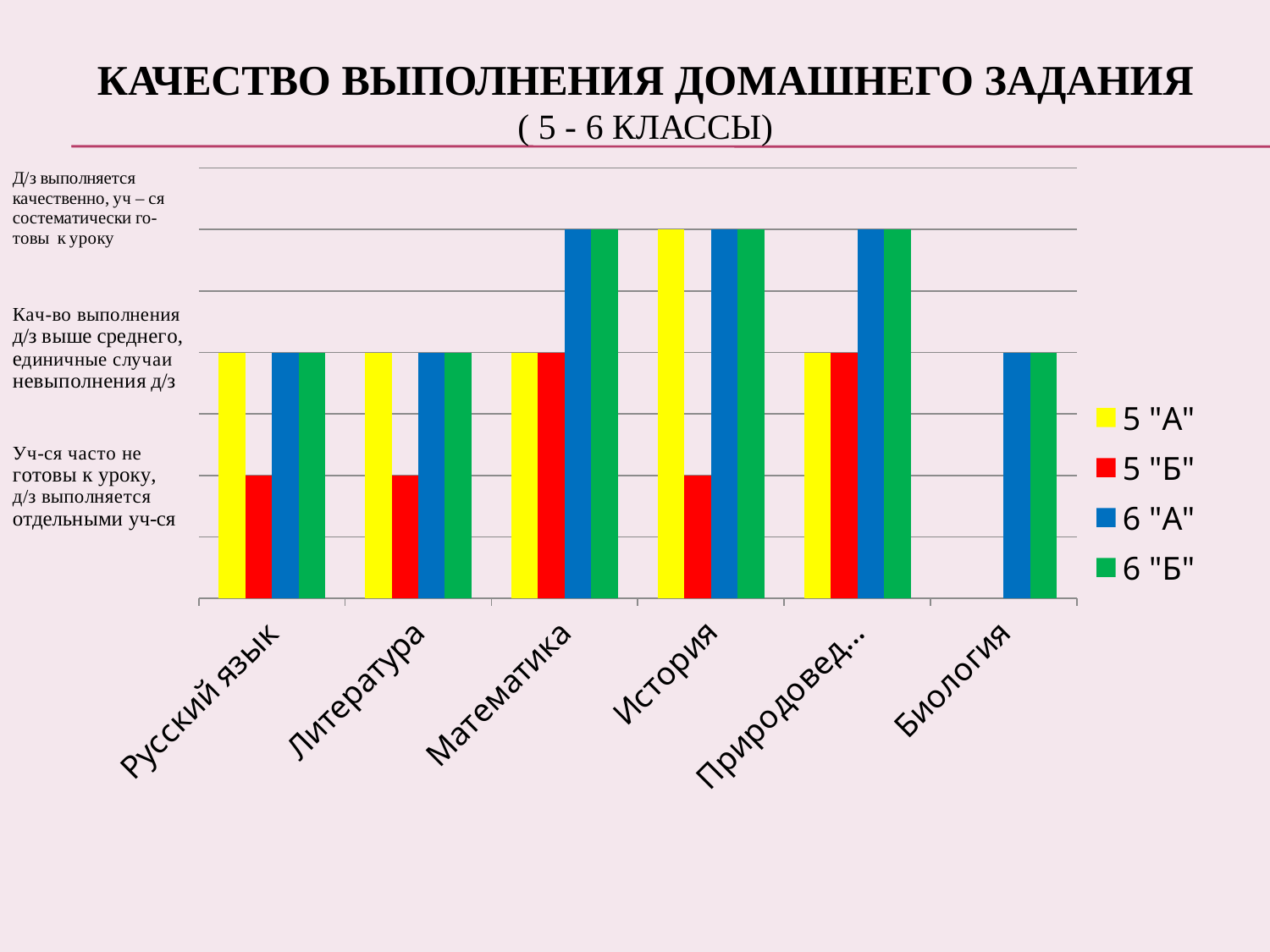
For the 5 "А" series, which subject has the highest bar? История For Русский язык, which is lower: the bar for 5 "А" or the bar for 5 "Б"? 5 "Б" How many series does the legend list? 4 For История, which is higher: the bar for 5 "А" or the bar for 5 "Б"? 5 "А" For Математика, which is higher: the bar for 5 "Б" or the bar for 6 "А"? 6 "А" How many subject categories are shown on the x axis? 6 Which subject has bars only for 6 "А" and 6 "Б"? Биология What is the title of the chart? КАЧЕСТВО ВЫПОЛНЕНИЯ ДОМАШНЕГО ЗАДАНИЯ ( 5 - 6 КЛАССЫ) What kind of chart is shown on the slide? bar chart How many bars are shown for Биология? 2 Which series are listed in the legend? 5 "А", 5 "Б", 6 "А", 6 "Б"